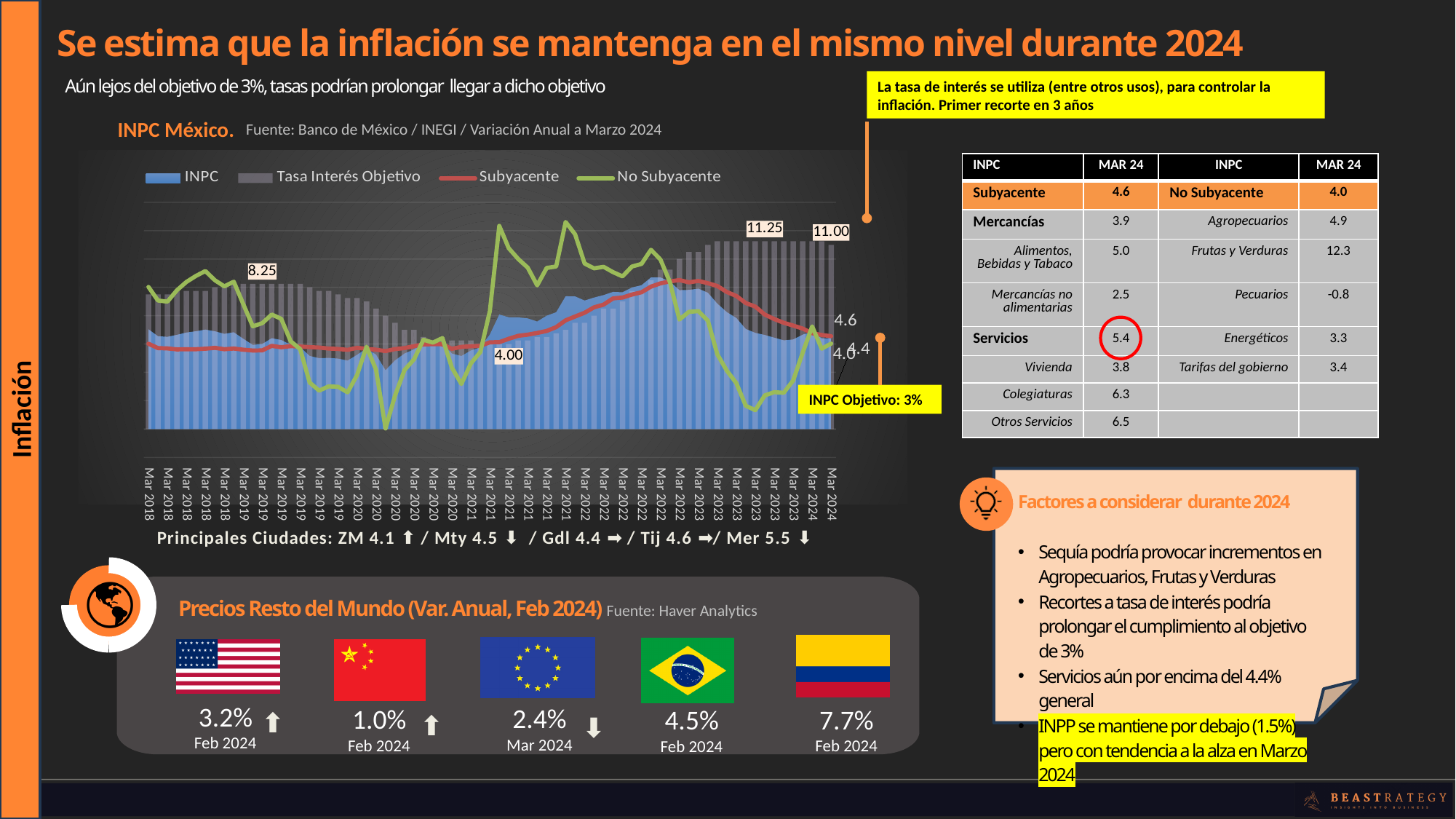
What is the lowest labelled value of the Tasa Interés Objetivo series in the INPC México chart? 4.00 In the INPC México chart, what is the difference between the peak Tasa Interés Objetivo label (11.25) and the final label (11.00)? 0.25 What is the labelled value of the Subyacente series at Mar 2024 in the INPC México chart? 4.6 What is the labelled value of the Tasa Interés Objetivo series around Mar 2019 in the INPC México chart? 8.25 In the INPC México chart, does the Tasa Interés Objetivo series rise or fall between Mar 2021 and Mar 2023? rise What is the labelled value of the Tasa Interés Objetivo series at the end of the INPC México chart (Mar 2024)? 11.00 What is the highest labelled value of the Tasa Interés Objetivo series in the INPC México chart? 11.25 What colour is the No Subyacente line in the INPC México chart? green In the INPC México chart, what is the difference between the Tasa Interés Objetivo labels 8.25 and 4.00? 4.25 In the INPC México chart, which labelled Tasa Interés Objetivo value is larger: 8.25 or 11.25? 11.25 How many series does the legend of the INPC México chart list? 4 In the INPC México chart, what is the difference between the Tasa Interés Objetivo labels 11.25 and 4.00? 7.25